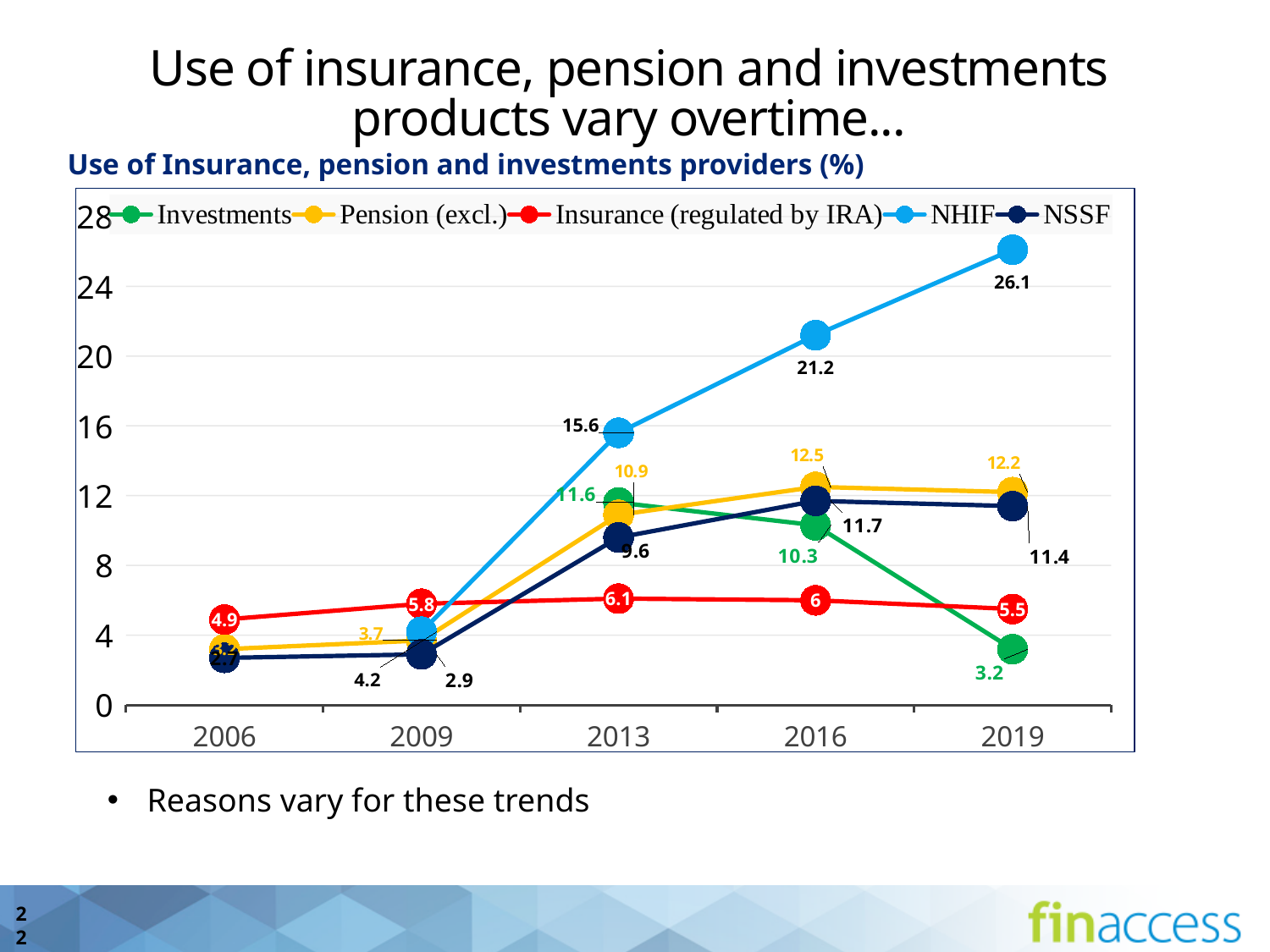
What kind of chart is shown on the slide? Line chart Is the NHIF value in 2019 greater or less than 24? greater In 2019, which is larger: Pension (excl.) or NSSF? Pension (excl.) Which series has the highest value in 2019? NHIF What is the Pension (excl.) value in 2016? 12.5 What is the NHIF value in 2016? 21.2 What is the NHIF value in 2019? 26.1 By how much did the NHIF value increase from 2016 to 2019? 4.9 What is the NSSF value in 2013? 9.6 How many series does the legend list? 5 What is the Investments value in 2019? 3.2 What is the value for Insurance (regulated by IRA) in 2006? 4.9